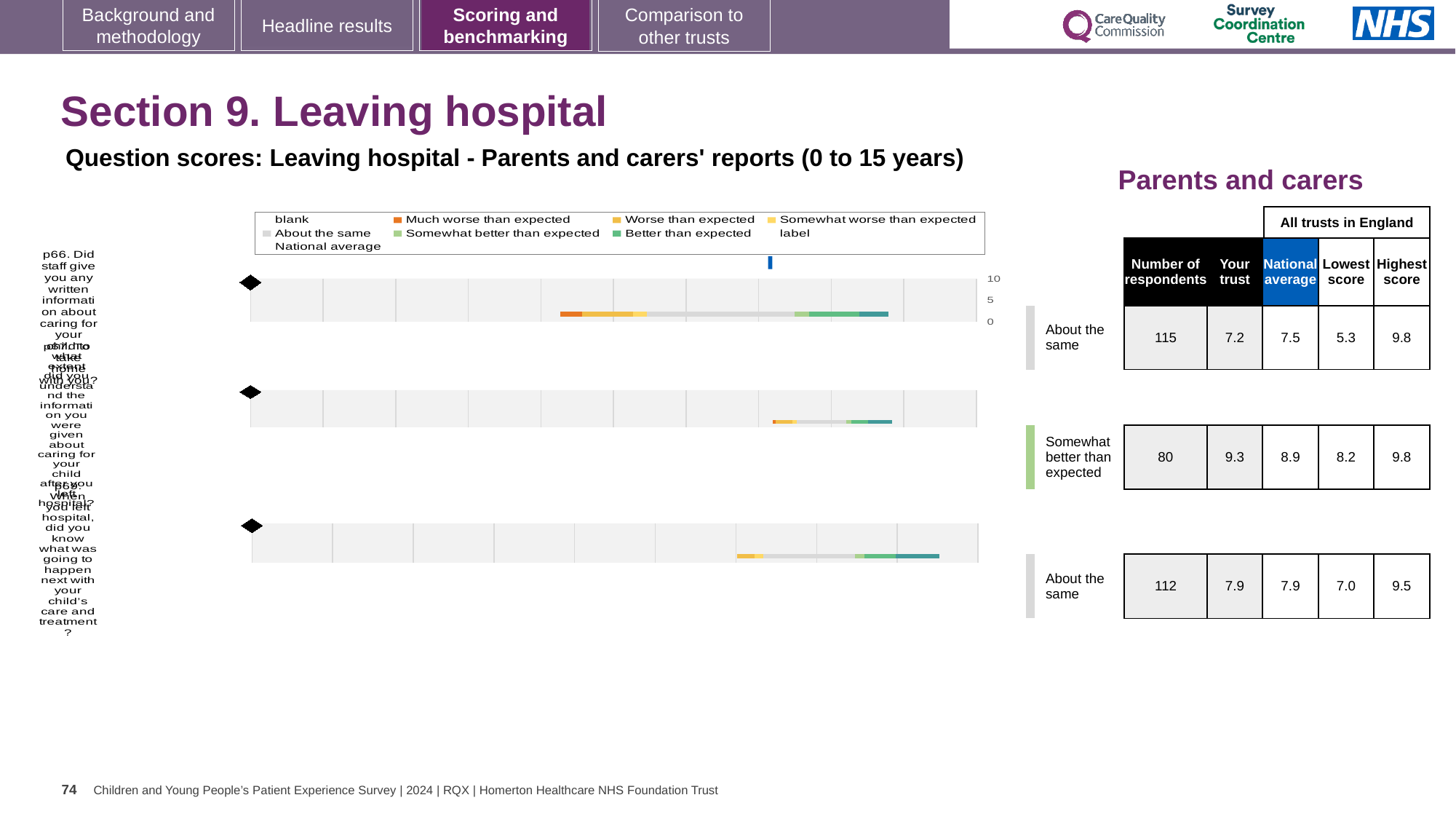
In the table on the right, what is the difference between the "Your trust" score and the national average for the "Somewhat better than expected" row? 0.4 In the table on the right, for the first row, which is larger: the "Your trust" score or the national average? National average In the table on the right, which row has the highest "Your trust" score? Somewhat better than expected What is the highest tick value shown on the chart axis? 10 In the table on the right, what is the highest score for the third row (About the same)? 9.5 In the table on the right, what is the national average for the row labelled "Somewhat better than expected"? 8.9 In the table on the right, what is the "Your trust" score for the first row (About the same)? 7.2 What colour represents "Much worse than expected" in the legend? orange What kind of chart is used to show the question scores on this slide? bar chart In the table on the right, what is the number of respondents for the third row (About the same)? 112 How many separate bar charts are shown on the slide? 3 How many entries does the legend above the charts list? 9